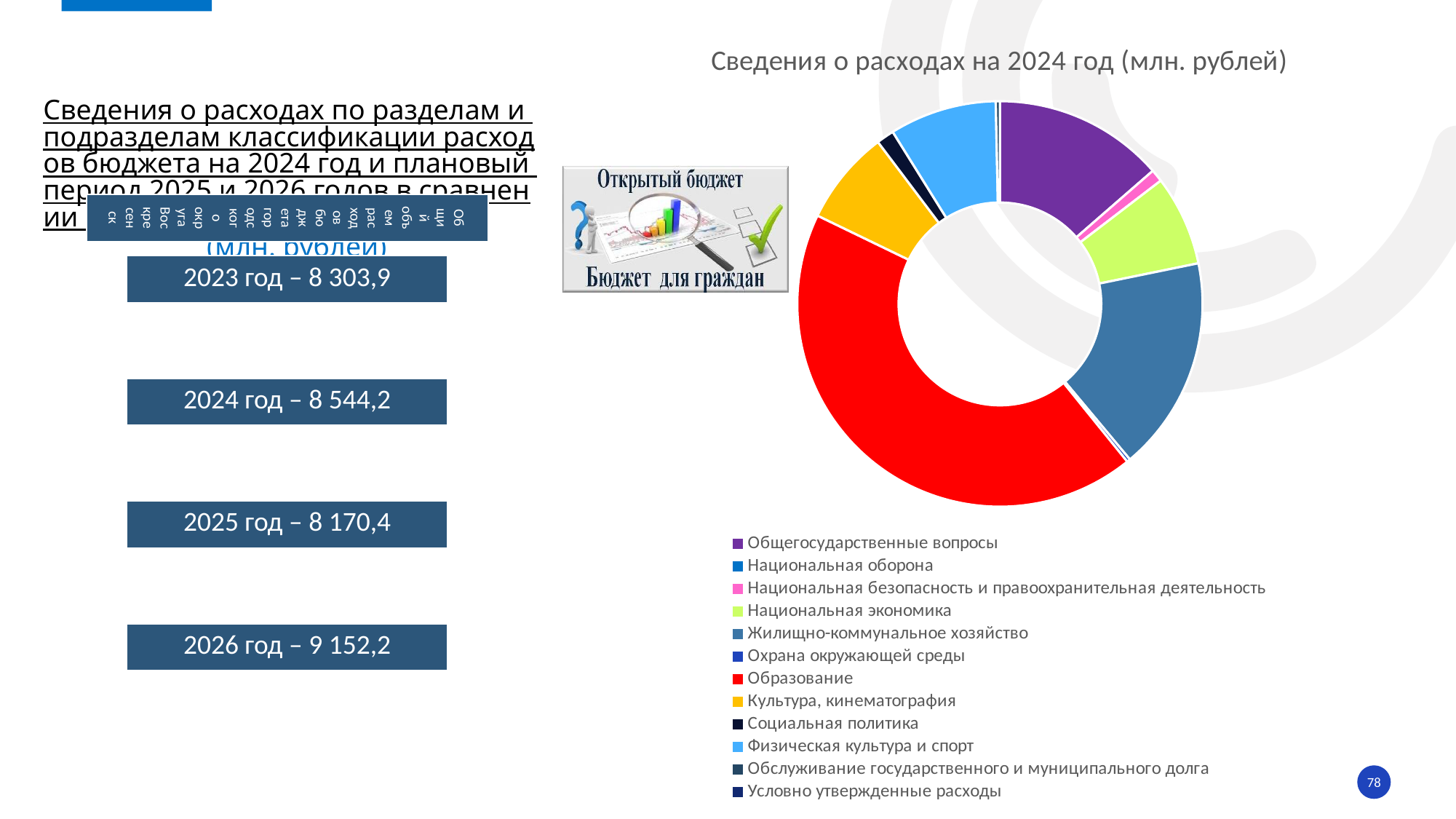
In the doughnut chart, which is larger: Образование or Жилищно-коммунальное хозяйство? Образование In the doughnut chart, which is larger: Физическая культура и спорт or Национальная безопасность и правоохранительная деятельность? Физическая культура и спорт Which category has the largest slice in the doughnut chart? Образование In the doughnut chart, which is larger: Культура, кинематография or Социальная политика? Культура, кинематография How many categories does the legend of the doughnut chart list? 12 What is the title of the doughnut chart? Сведения о расходах на 2024 год (млн. рублей) What colour represents Образование in the doughnut chart? Red What kind of chart is shown on the right side of the slide? Doughnut (pie) chart